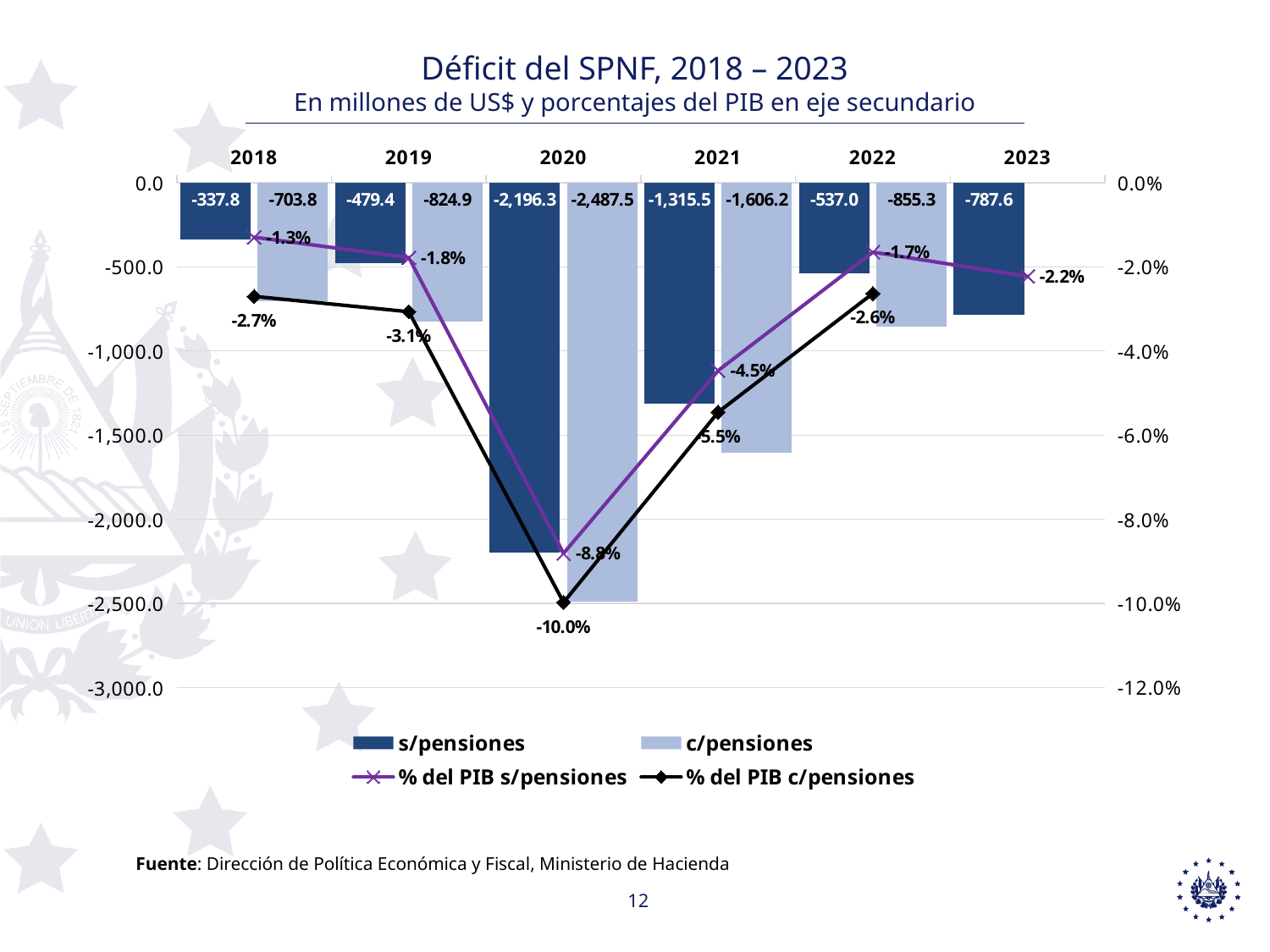
What kind of chart is shown on the slide? Combination bar and line chart In which year is the s/pensiones deficit the smallest in magnitude (closest to zero)? 2018 What is the difference in percentage points between % del PIB c/pensiones and % del PIB s/pensiones in 2020? 1.2 What is the c/pensiones value for 2021? -1,606.2 How many years are shown on the x axis? 6 Which is larger in magnitude, the s/pensiones deficit in 2021 or in 2022? 2021 What is the % del PIB s/pensiones value for 2023? -2.2% How many series does the legend list? 4 What is the difference between the c/pensiones and s/pensiones values in 2020? 291.2 In which year is the c/pensiones deficit the largest (most negative)? 2020 What is the s/pensiones value for 2020? -2,196.3 What is the % del PIB c/pensiones value for 2019? -3.1%